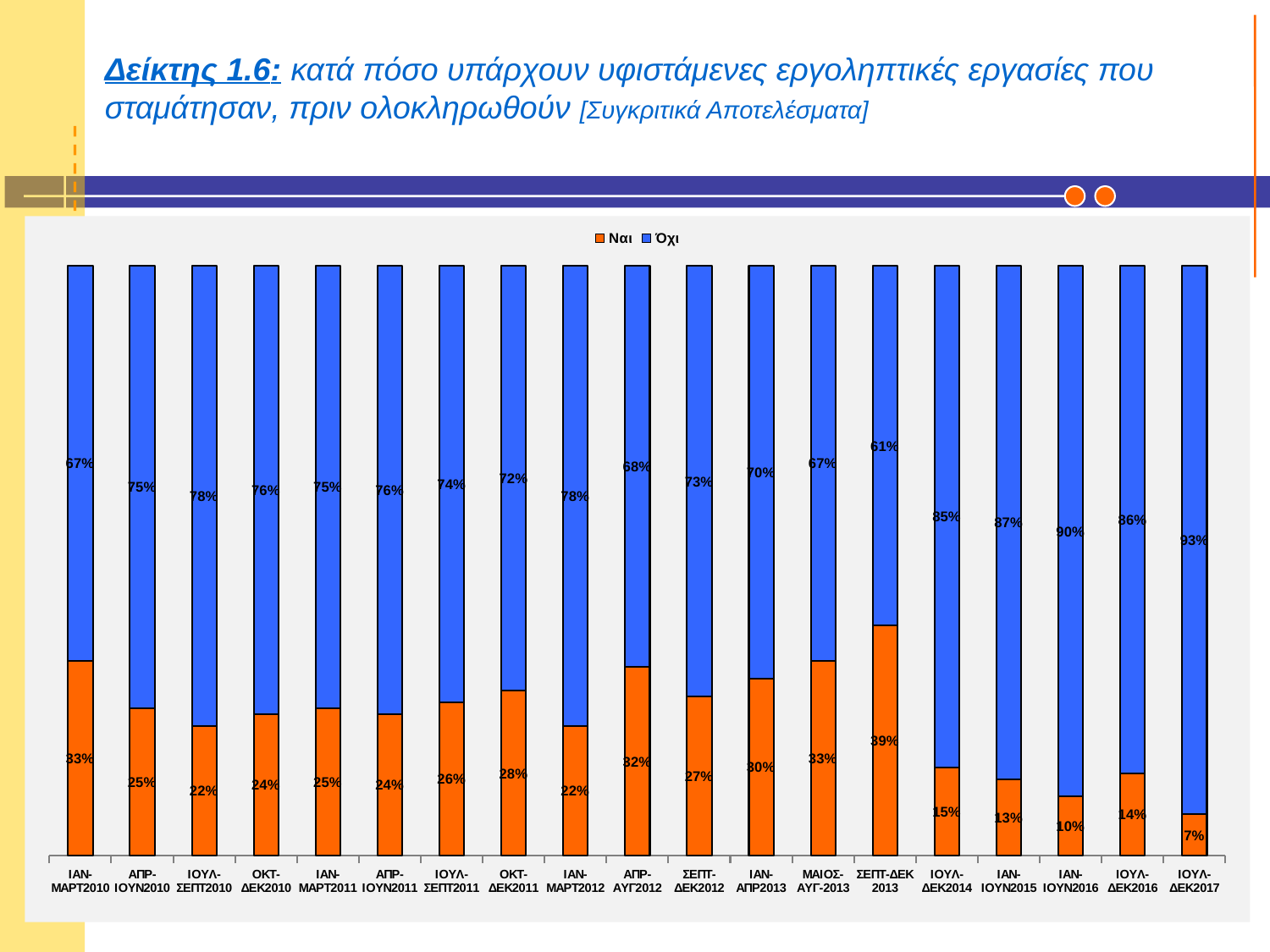
How many periods are shown on the x axis? 19 Which is larger, the Ναι value for ΑΠΡ-ΑΥΓ2012 or for ΣΕΠΤ-ΔΕΚ2012? ΑΠΡ-ΑΥΓ2012 How many series does the legend list? 2 Which period has the lowest Ναι value? ΙΟΥΛ-ΔΕΚ2017 What is the difference between the Όχι values for ΙΟΥΛ-ΔΕΚ2017 and ΙΑΝ-ΜΑΡΤ2010? 26% Which colour represents the Ναι series? Orange What is the value of Ναι for ΙΑΝ-ΜΑΡΤ2010? 33% What is the total of the stacked bar for ΙΑΝ-ΙΟΥΝ2016? 100% What is the value of Ναι for ΣΕΠΤ-ΔΕΚ 2013? 39% Which period has the highest Ναι value? ΣΕΠΤ-ΔΕΚ 2013 What kind of chart is shown? Stacked bar chart What is the value of Όχι for ΙΟΥΛ-ΔΕΚ2017? 93%